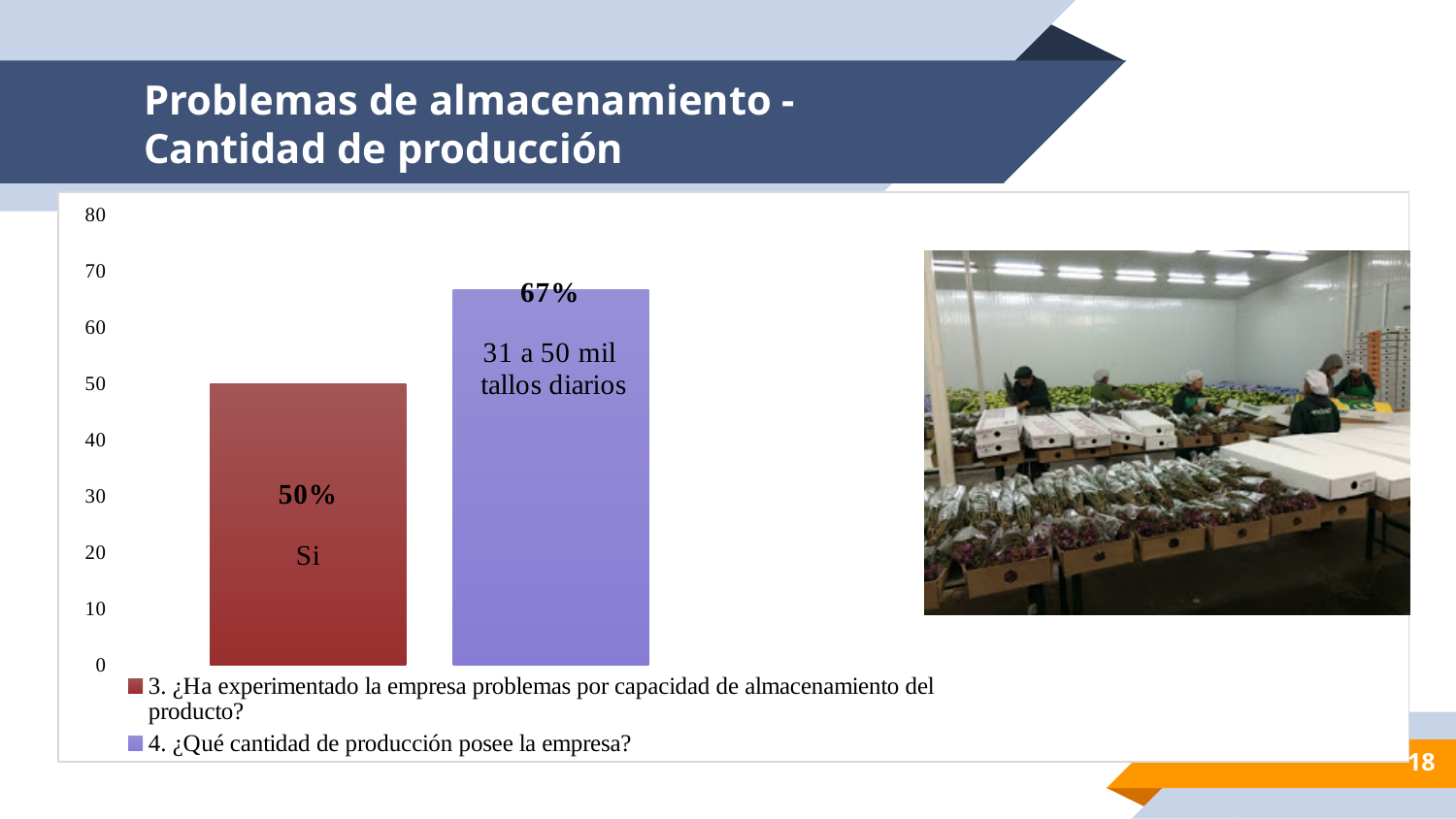
What kind of chart is shown on the slide? bar chart Is the value for "31 a 50 mil tallos diarios" greater or less than 60? greater How many series does the legend list? 2 What value is shown on the bar labelled "Si"? 50% What value is shown on the bar labelled "31 a 50 mil tallos diarios"? 67% Is the value for "Si" greater or less than 60? less Which bar has the highest value? 31 a 50 mil tallos diarios How many bars are plotted in the chart? 2 What is the difference between the value for "31 a 50 mil tallos diarios" and the value for "Si"? 17% Which is larger, the value for "Si" or the value for "31 a 50 mil tallos diarios"? 31 a 50 mil tallos diarios Which bar has the lowest value? Si What is the highest value shown on the vertical axis? 80